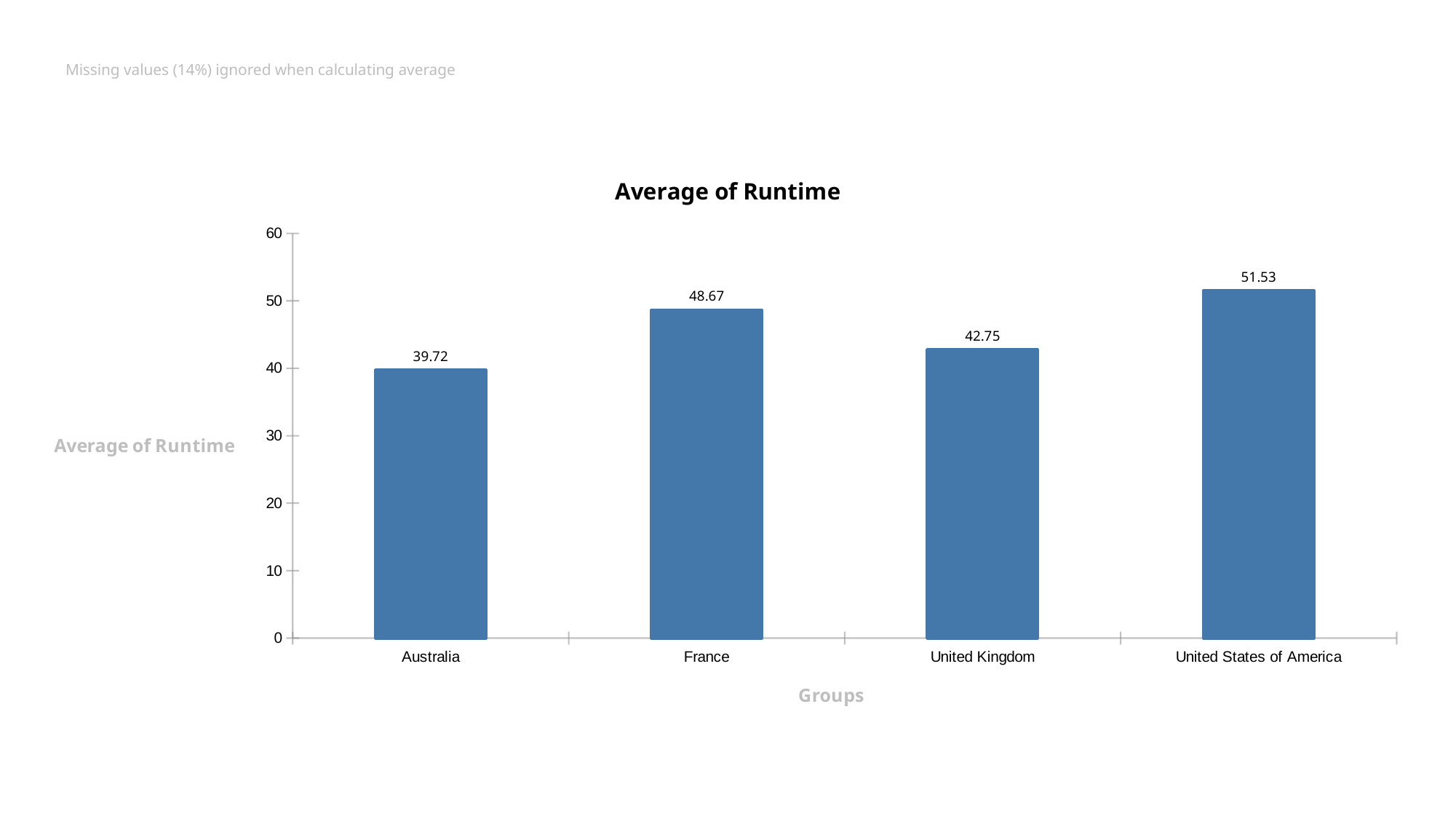
Which group has the highest average runtime? United States of America What is the average runtime for France? 48.67 What is the difference between the average runtime of the United States of America and Australia? 11.81 What is the difference between the average runtime of France and the United Kingdom? 5.92 What is the average runtime for the United Kingdom? 42.75 How many groups are shown on the chart? 4 Is the average runtime for the United Kingdom greater or less than 50? less Which has a higher average runtime, France or the United Kingdom? France Which group has the lowest average runtime? Australia What is the average runtime for the United States of America? 51.53 What is the average runtime for Australia? 39.72 What type of chart is shown on the slide? Bar chart